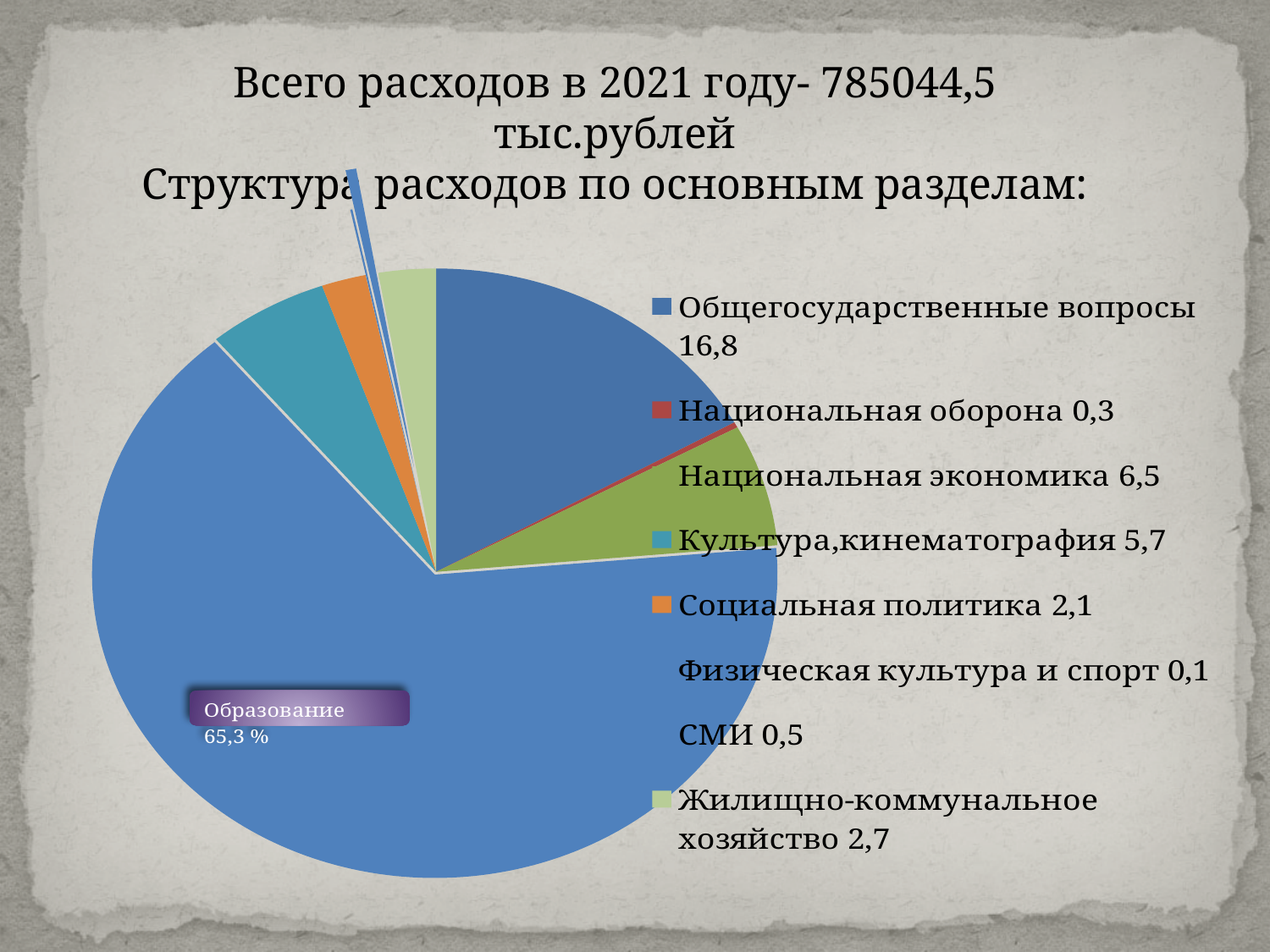
What value is shown for Жилищно-коммунальное хозяйство? 2,7 How many entries does the legend list? 8 What value is shown for Культура,кинематография? 5,7 What kind of chart is shown on the slide? pie chart Which is larger, the value for Социальная политика or the value for СМИ? Социальная политика Which legend entry has the largest value? Общегосударственные вопросы What share is shown for Образование in the label on the pie? 65,3 % Which legend entry has the smallest value? Физическая культура и спорт What value is shown for Общегосударственные вопросы in the legend? 16,8 What is the total expenditure for 2021 stated in the slide title? 785044,5 тыс.рублей What value is shown for Национальная экономика? 6,5 What is the difference between the values for Общегосударственные вопросы and Национальная экономика? 10,3